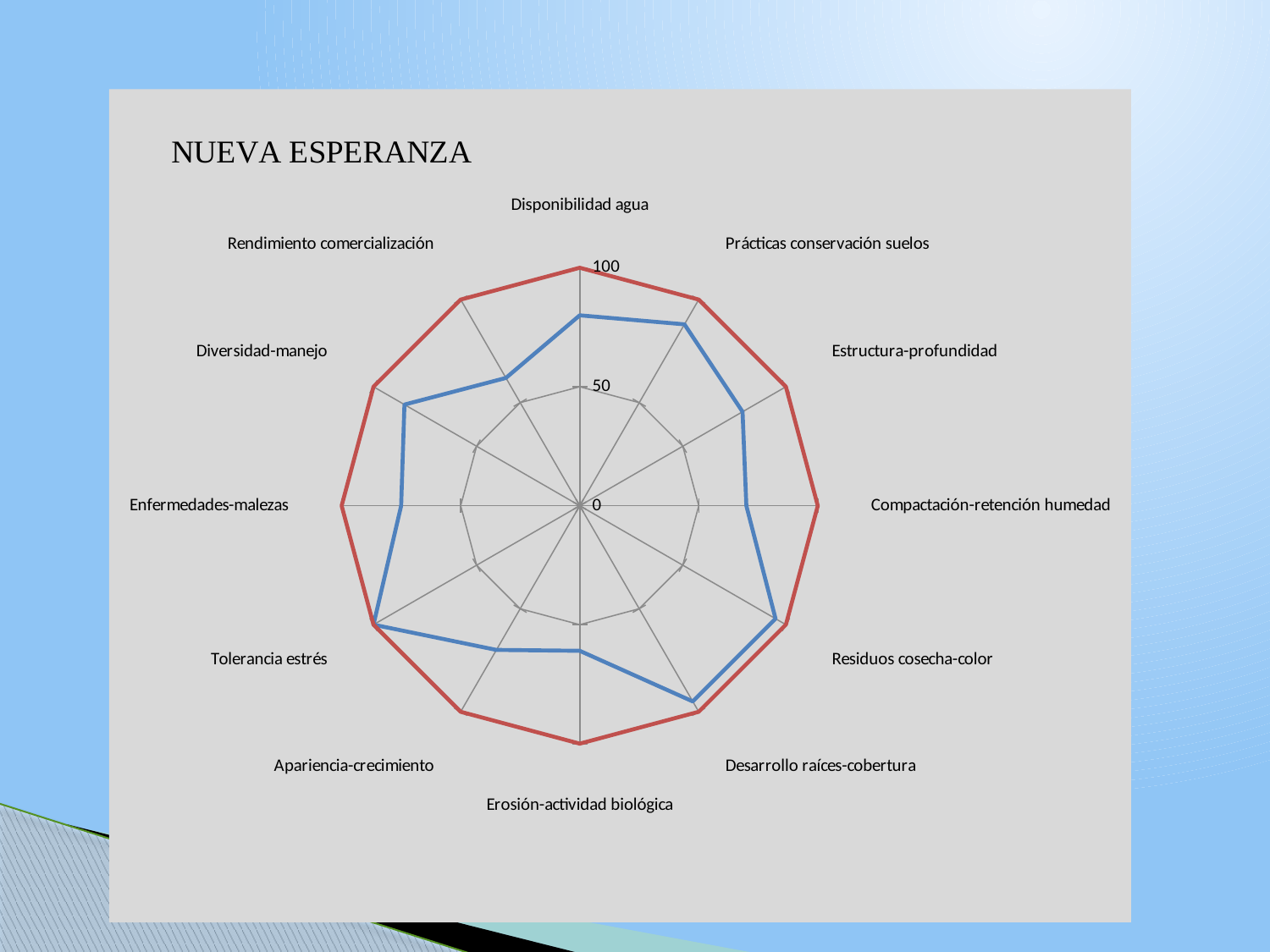
For the blue series, which is larger: Residuos cosecha-color or Compactación-retención humedad? Residuos cosecha-color What colours are the two series lines on the chart? Red and blue What is the value of the red series for Disponibilidad agua? 100 What is the maximum value shown on the radial axis? 100 How many categories (axes) does the radar chart have? 12 What is the title of the chart? NUEVA ESPERANZA Is the blue series value for Compactación-retención humedad greater or less than 50? greater Is the blue series value for Disponibilidad agua greater or less than 50? greater For the blue series, which is larger: Tolerancia estrés or Erosión-actividad biológica? Tolerancia estrés What kind of chart is shown on the slide? Radar chart Is the blue series value for Erosión-actividad biológica greater or less than 50? greater How many data series are plotted on the radar chart? 2